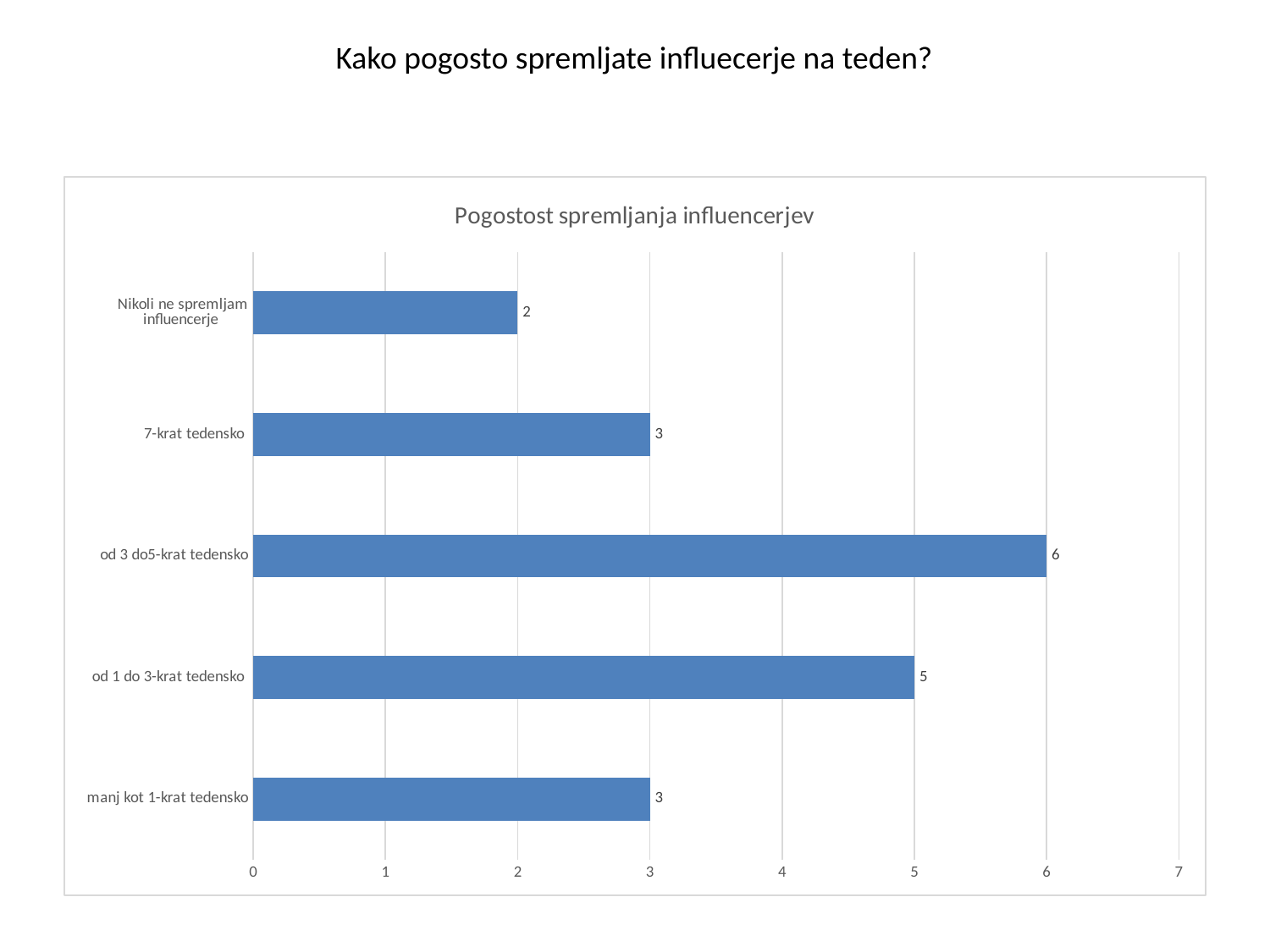
What is the difference between the values for "7-krat tedensko" and "Nikoli ne spremljam influencerje"? 1 What is the difference between the values for "od 3 do5-krat tedensko" and "od 1 do 3-krat tedensko"? 1 What is the value for "od 1 do 3-krat tedensko"? 5 How many categories are shown in the chart? 5 Which category has the highest value? od 3 do5-krat tedensko What kind of chart is shown on the slide? bar chart What is the title of the chart? Pogostost spremljanja influencerjev What is the value for "Nikoli ne spremljam influencerje"? 2 Which is larger, the value for "7-krat tedensko" or the value for "od 1 do 3-krat tedensko"? od 1 do 3-krat tedensko Which category has the lowest value? Nikoli ne spremljam influencerje What is the value for "od 3 do5-krat tedensko"? 6 Is the value for "od 3 do5-krat tedensko" greater or less than 4? greater